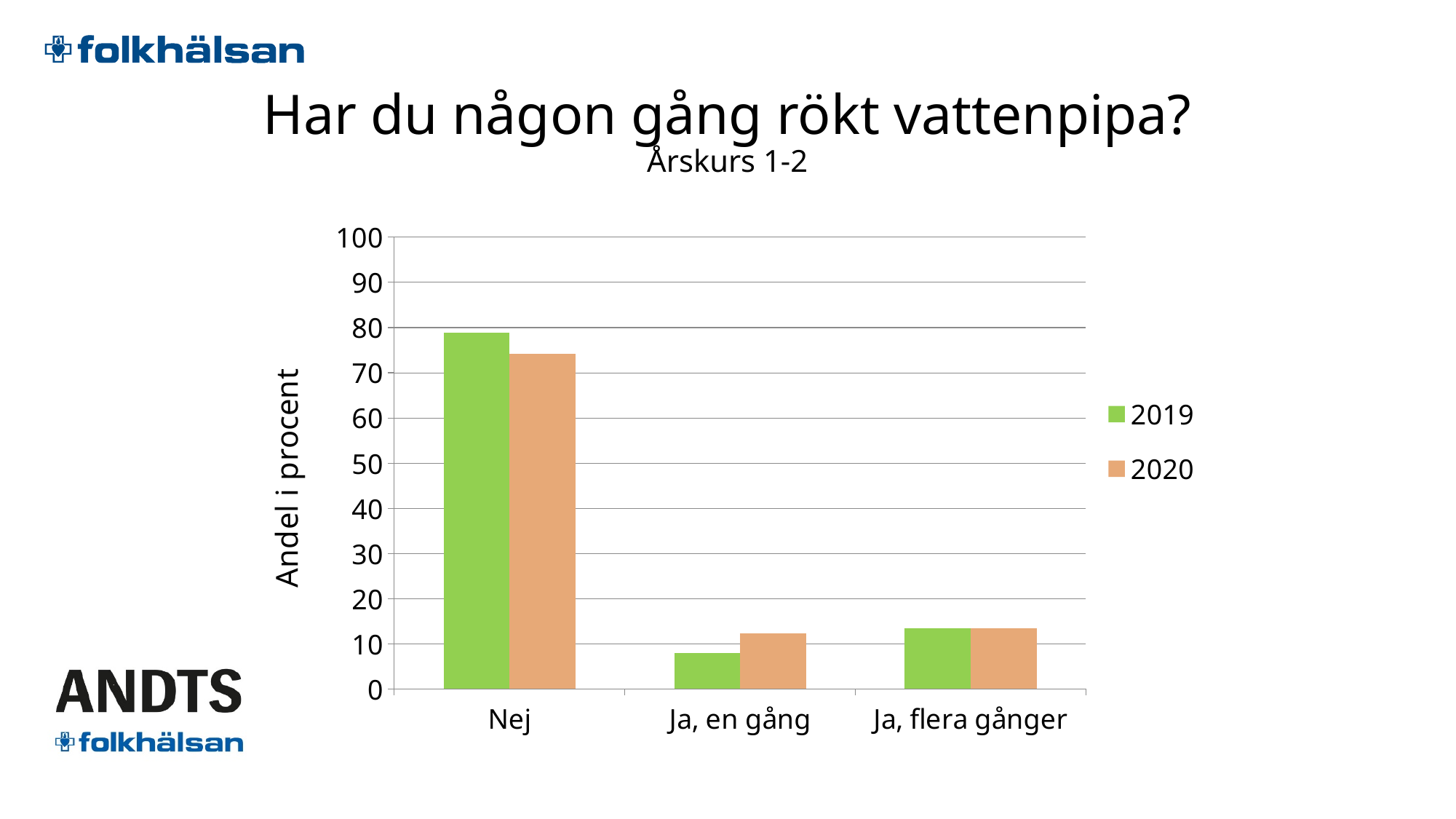
Which category has the highest value for 2020? Nej How many categories are shown on the x axis? 3 Which category has the lowest value for 2019? Ja, en gång Which category has the highest value for 2019? Nej How many series does the legend list? 2 What kind of chart is shown on the slide? bar chart For the category Ja, en gång, which series has the larger value, 2019 or 2020? 2020 Is the value for Ja, flera gånger in 2020 greater or less than 20? less For the category Nej, which series has the larger value, 2019 or 2020? 2019 Is the value for Ja, en gång in 2019 greater or less than 10? less What is the label of the y axis? Andel i procent Is the value for Nej in 2019 greater or less than 70? greater